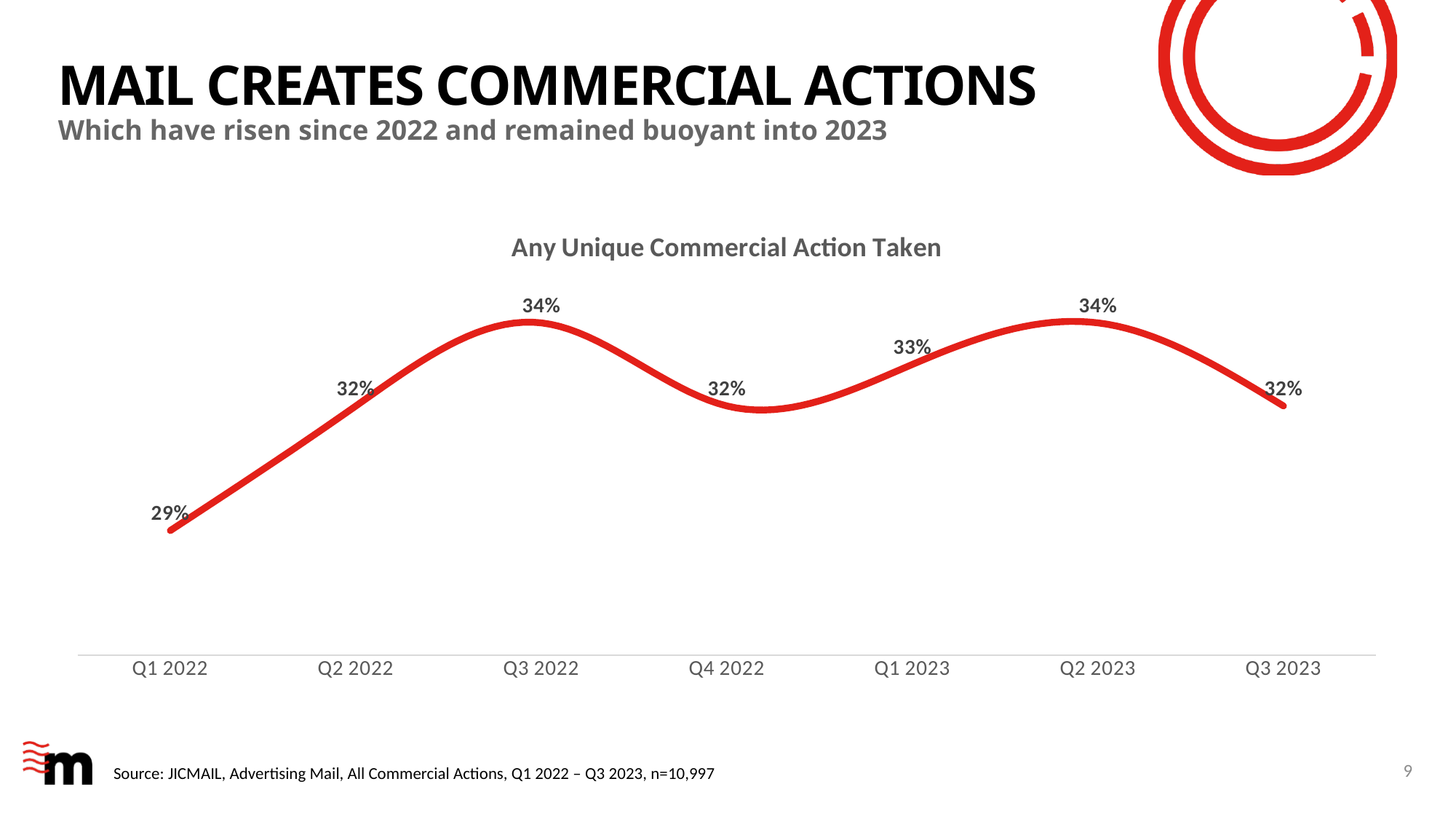
What is the title of the chart? Any Unique Commercial Action Taken What is the difference between the values for Q2 2023 and Q3 2023? 2% What is the difference between the values for Q3 2022 and Q1 2022? 5% What is the value for Q3 2023? 32% What kind of chart is shown on the slide? Line chart What is the value for Q1 2023? 33% What is the value for Q3 2022? 34% How many quarters are plotted on the chart? 7 Which quarter has the lowest value? Q1 2022 Does the value rise or fall from Q1 2022 to Q3 2022? Rise Which is larger, the value for Q1 2023 or the value for Q4 2022? Q1 2023 What is the value for Q1 2022? 29%